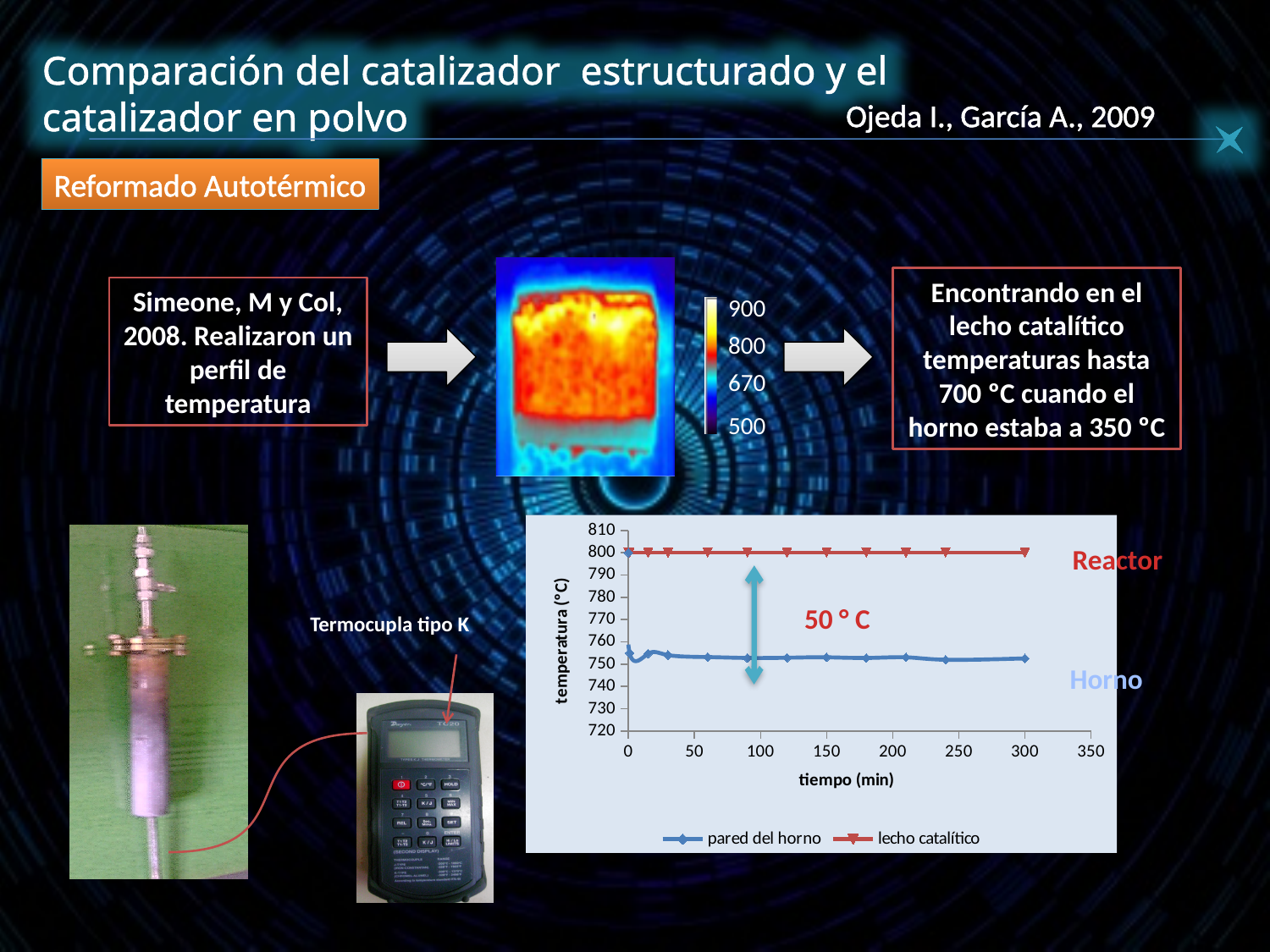
Which series has the higher temperature throughout the chart, pared del horno or lecho catalítico? lecho catalítico What kind of chart is shown on the slide? line chart Is the temperature of pared del horno greater or less than 740 °C? greater How many series does the chart legend list? 2 What is the highest tick value shown on the x axis of the chart? 350 What temperature difference between the two series is annotated on the chart? 50 ° C What is the label of the x axis of the chart? tiempo (min) What are the two series named in the chart legend? pared del horno and lecho catalítico Is the temperature of lecho catalítico greater or less than 790 °C? greater Does the temperature of lecho catalítico rise, fall, or stay roughly constant as time increases? stays roughly constant